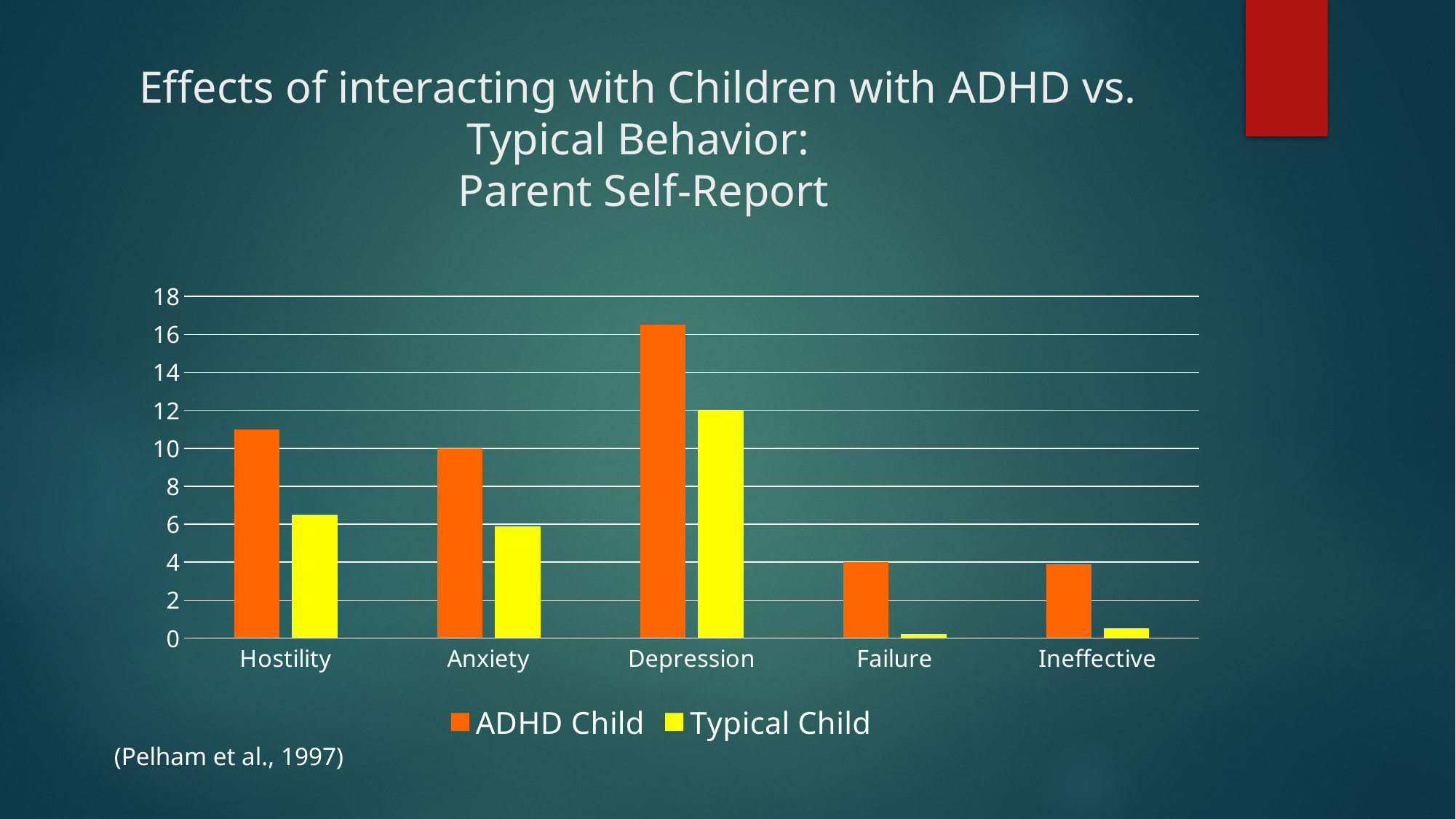
Is the value for Typical Child in the Failure category greater or less than 2? less What kind of chart is shown on the slide? bar chart Is the value for ADHD Child in the Depression category greater or less than 16? greater Is the value for ADHD Child in the Hostility category greater or less than 10? greater What is the value for Typical Child in the Depression category? 12 How many categories are shown on the x axis of the chart? 5 What is the value for ADHD Child in the Anxiety category? 10 Which category has the highest value for the ADHD Child series? Depression How many series does the chart's legend list? 2 What colour are the bars for the ADHD Child series? orange Which category has the highest value for the Typical Child series? Depression In the Hostility category, which series has the larger value, ADHD Child or Typical Child? ADHD Child